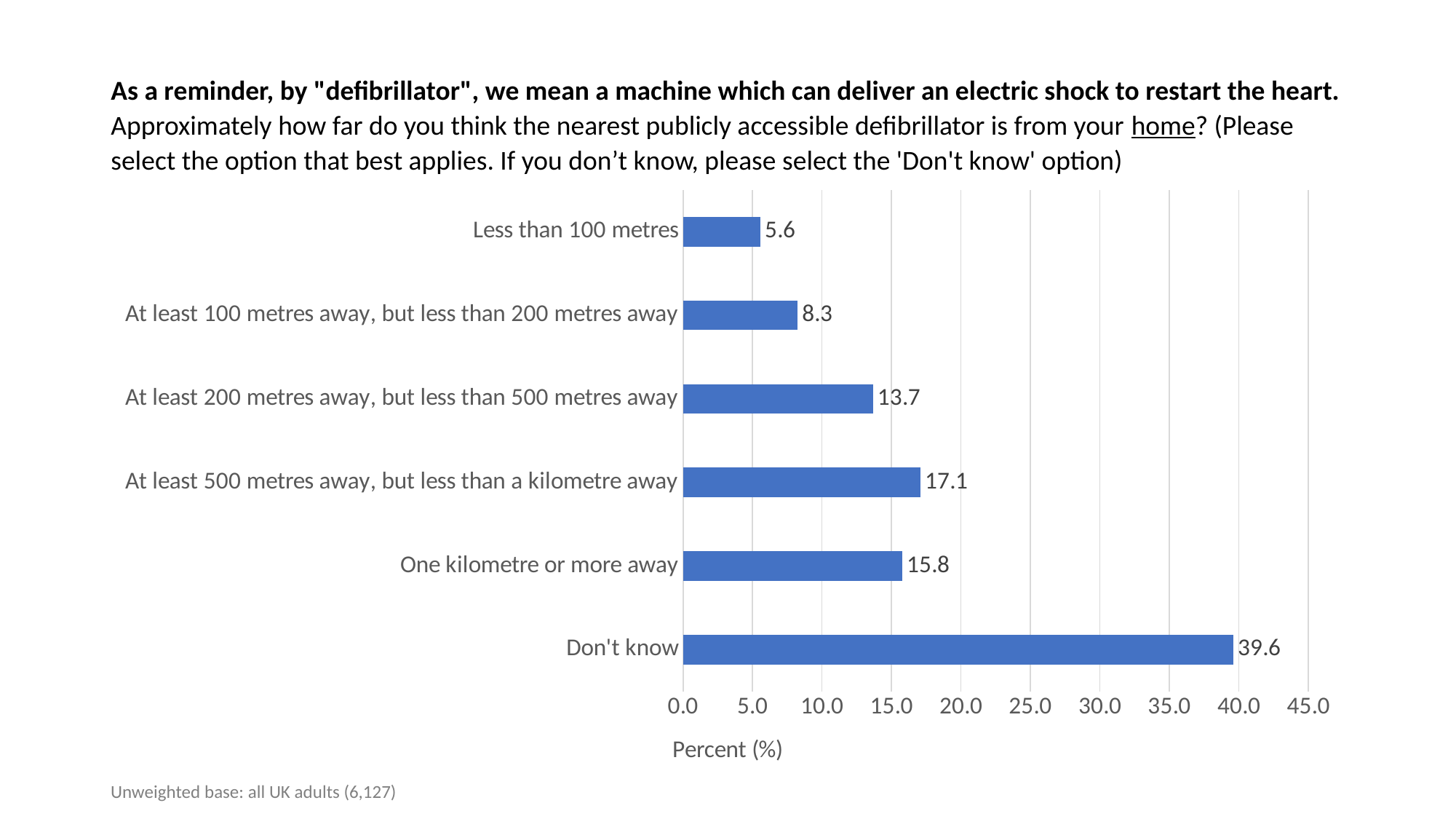
What is the value for 'At least 500 metres away, but less than a kilometre away'? 17.1 How many categories are shown in the chart? 6 Which category has the lowest value? Less than 100 metres What kind of chart is shown on the slide? Bar chart Which category has the highest value? Don't know What is the difference between the values for 'Don't know' and 'One kilometre or more away'? 23.8 What is the value for 'One kilometre or more away'? 15.8 What percentage of respondents said the nearest publicly accessible defibrillator is less than 100 metres from their home? 5.6 Is the value for 'At least 500 metres away, but less than a kilometre away' greater or less than 15.0? greater What is the label of the horizontal axis? Percent (%) What is the value for 'Don't know'? 39.6 Which is larger: the value for 'At least 200 metres away, but less than 500 metres away' or the value for 'At least 100 metres away, but less than 200 metres away'? At least 200 metres away, but less than 500 metres away